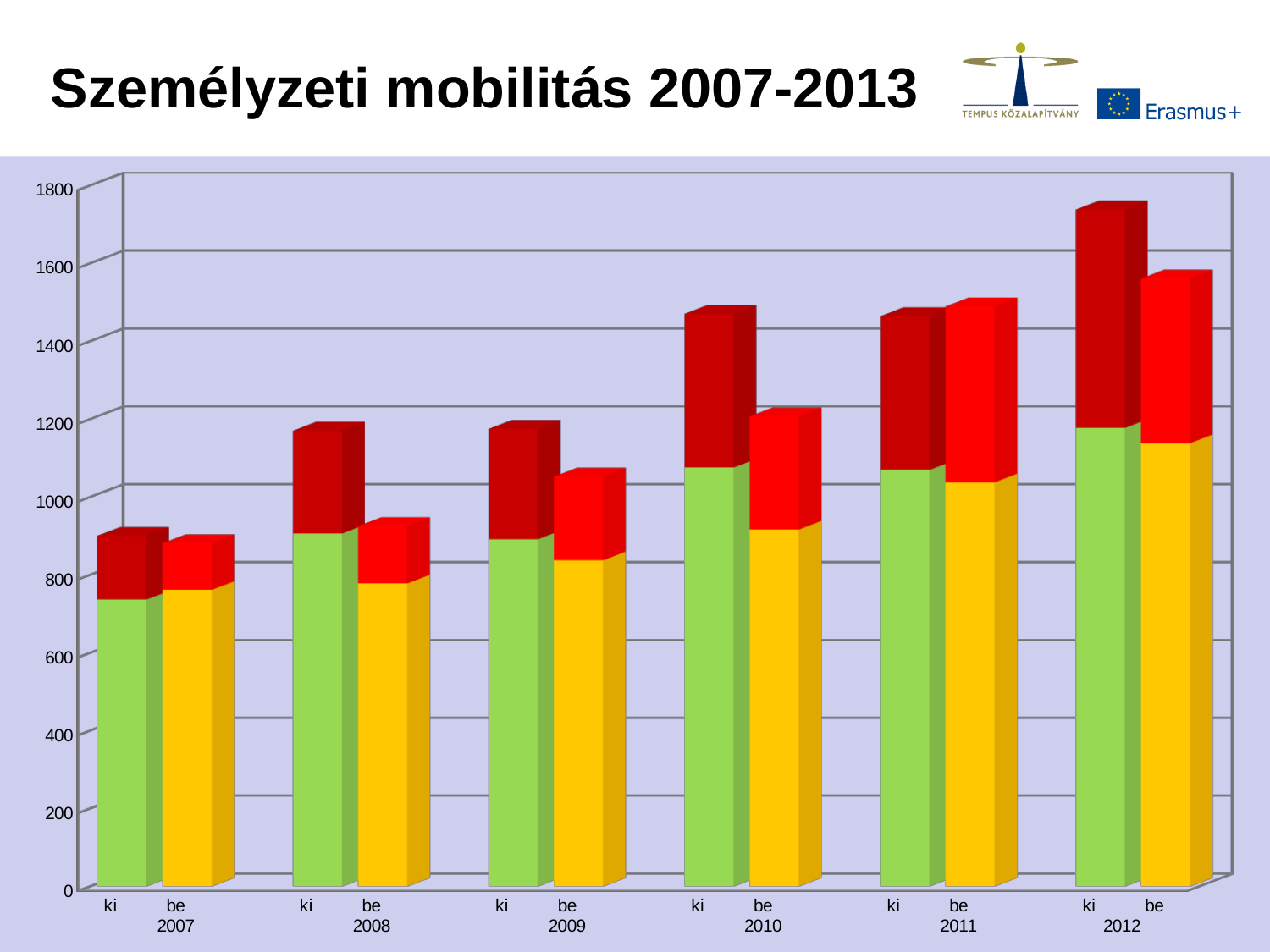
Which is larger in 2010, the total for ki or the total for be? ki What kind of chart is shown on the slide? stacked bar chart Which bar has the highest total value in the chart? ki 2012 Do the ki totals rise or fall from 2007 to 2012? rise Is the total value for ki 2012 greater or less than 1600? greater Is the total value for be 2008 greater or less than 1000? less Which is larger in 2012, the total for ki or the total for be? ki What is the title of the slide containing the chart? Személyzeti mobilitás 2007-2013 Is the total value for ki 2007 greater or less than 1000? less How many years are shown along the x axis of the chart? 6 How many bars are plotted in the chart? 12